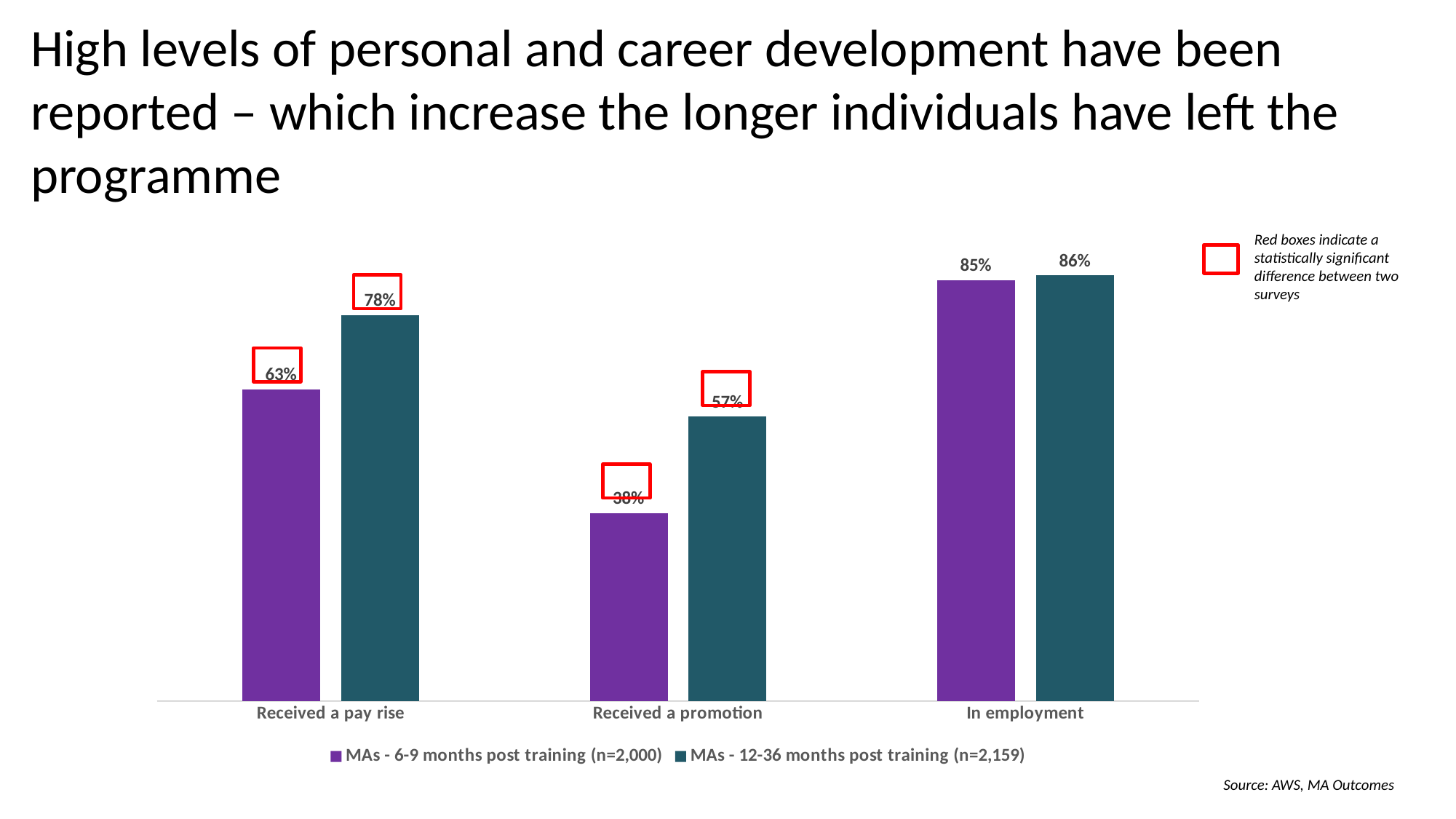
How many categories are shown on the x axis of the chart? 3 Which category has the lowest value for MAs 6-9 months post training? Received a promotion For 'Received a promotion', which series has the larger value: MAs 6-9 months post training or MAs 12-36 months post training? MAs - 12-36 months post training (n=2,159) What percentage of MAs 12-36 months post training received a promotion? 57% Which category has the highest value for MAs 12-36 months post training? In employment How many series does the chart legend list? 2 What percentage of MAs 12-36 months post training received a pay rise? 78% What percentage of MAs 6-9 months post training received a pay rise? 63% What percentage of MAs 6-9 months post training were in employment? 85% What percentage of MAs 12-36 months post training were in employment? 86% What is the difference between the 12-36 months and 6-9 months post training values for 'Received a pay rise'? 15 percentage points What type of chart is shown on the slide? Bar chart